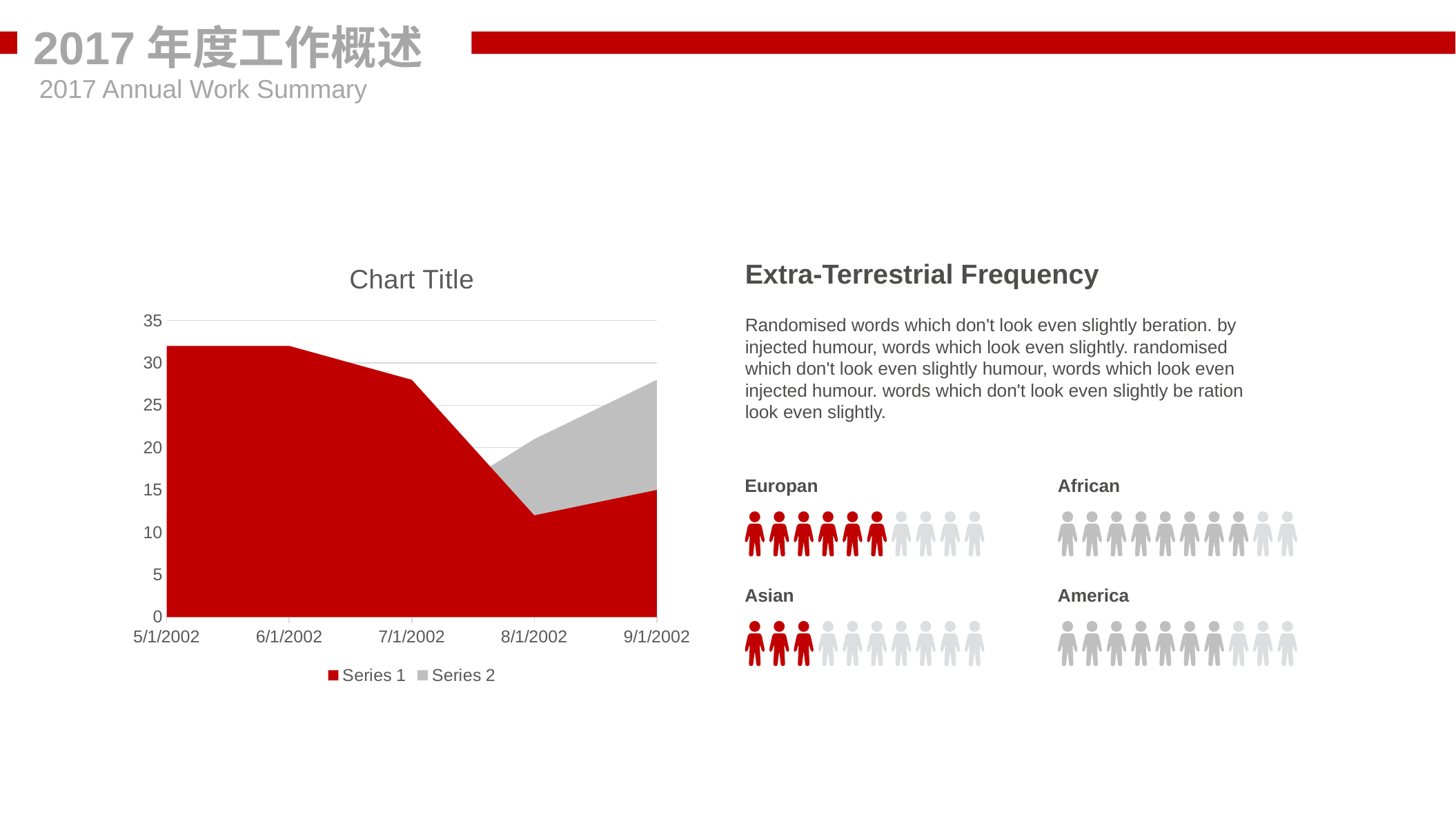
Is the value of Series 1 at 8/1/2002 greater or less than 15? less Does Series 1 rise or fall between 6/1/2002 and 8/1/2002? Fall What type of chart is shown on the left of the slide? Area chart At 9/1/2002, which series has the larger value, Series 1 or Series 2? Series 2 How many dates are shown along the x axis of the chart? 5 Is the value of Series 1 at 5/1/2002 greater or less than 30? greater Is the value of Series 1 at 7/1/2002 greater or less than 25? greater How many series does the chart's legend list? 2 At which date does Series 1 reach its lowest value? 8/1/2002 What is the title of the chart on the left of the slide? Chart Title Which colour represents Series 2 in the chart? Grey